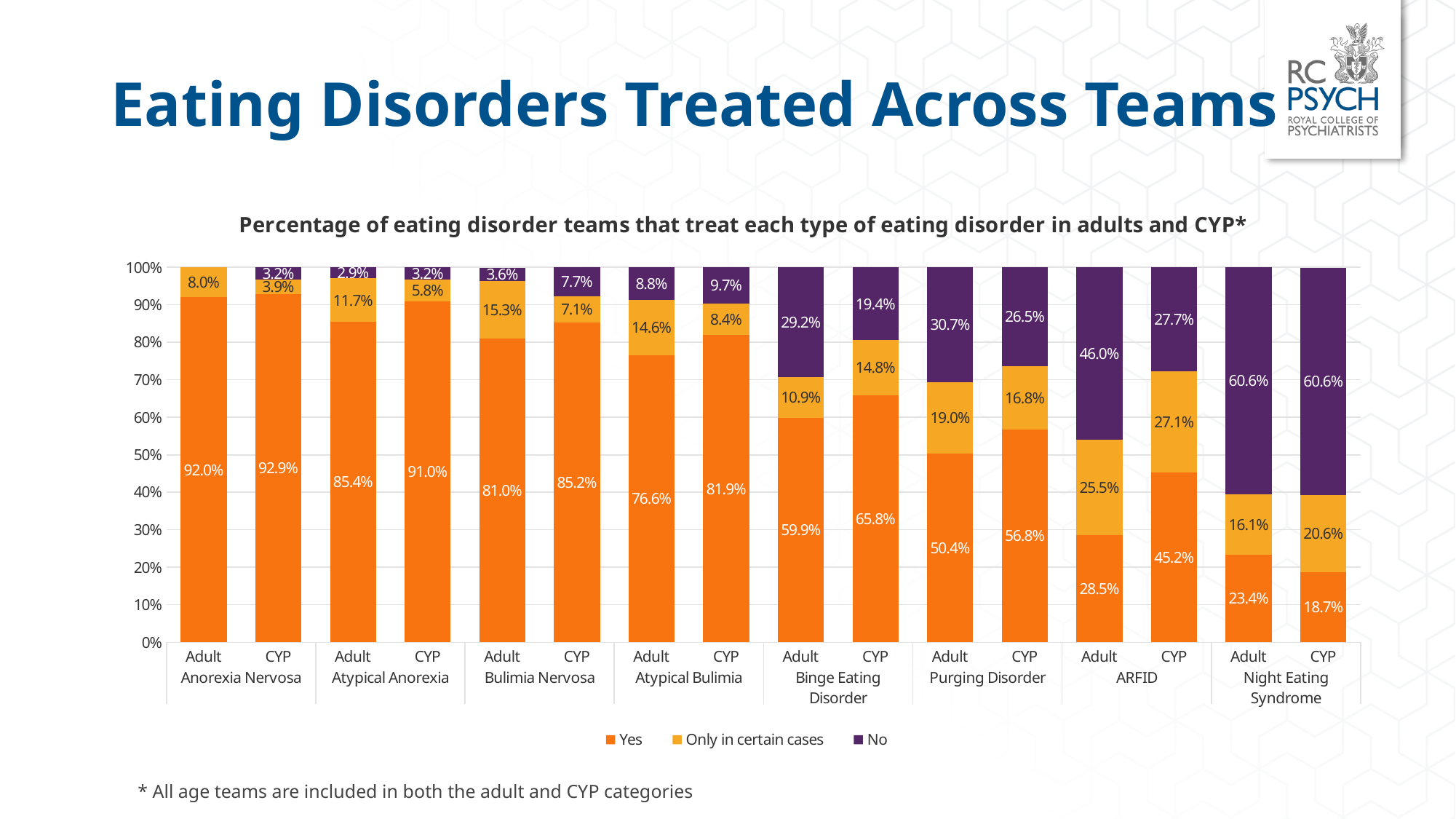
What is the "Only in certain cases" value for CYP Purging Disorder? 16.8% What is the difference between the "Yes" values for Adult ARFID and CYP ARFID? 16.7% How many bars are plotted in the chart? 16 Which bar has the highest "Yes" value? CYP Anorexia Nervosa (92.9%) What percentage of teams answered "Yes" for treating Anorexia Nervosa in adults? 92.0% What is the "Yes" value for CYP Night Eating Syndrome? 18.7% Which is larger: the "No" value for Adult Binge Eating Disorder or for CYP Binge Eating Disorder? Adult Binge Eating Disorder (29.2%) What type of chart is shown on the slide? Stacked bar chart How many series does the legend list? 3 What are the three legend entries of the chart? Yes, Only in certain cases, No Which bar has the lowest "Yes" value? CYP Night Eating Syndrome (18.7%) What is the "No" value for ARFID in the Adult category? 46.0%